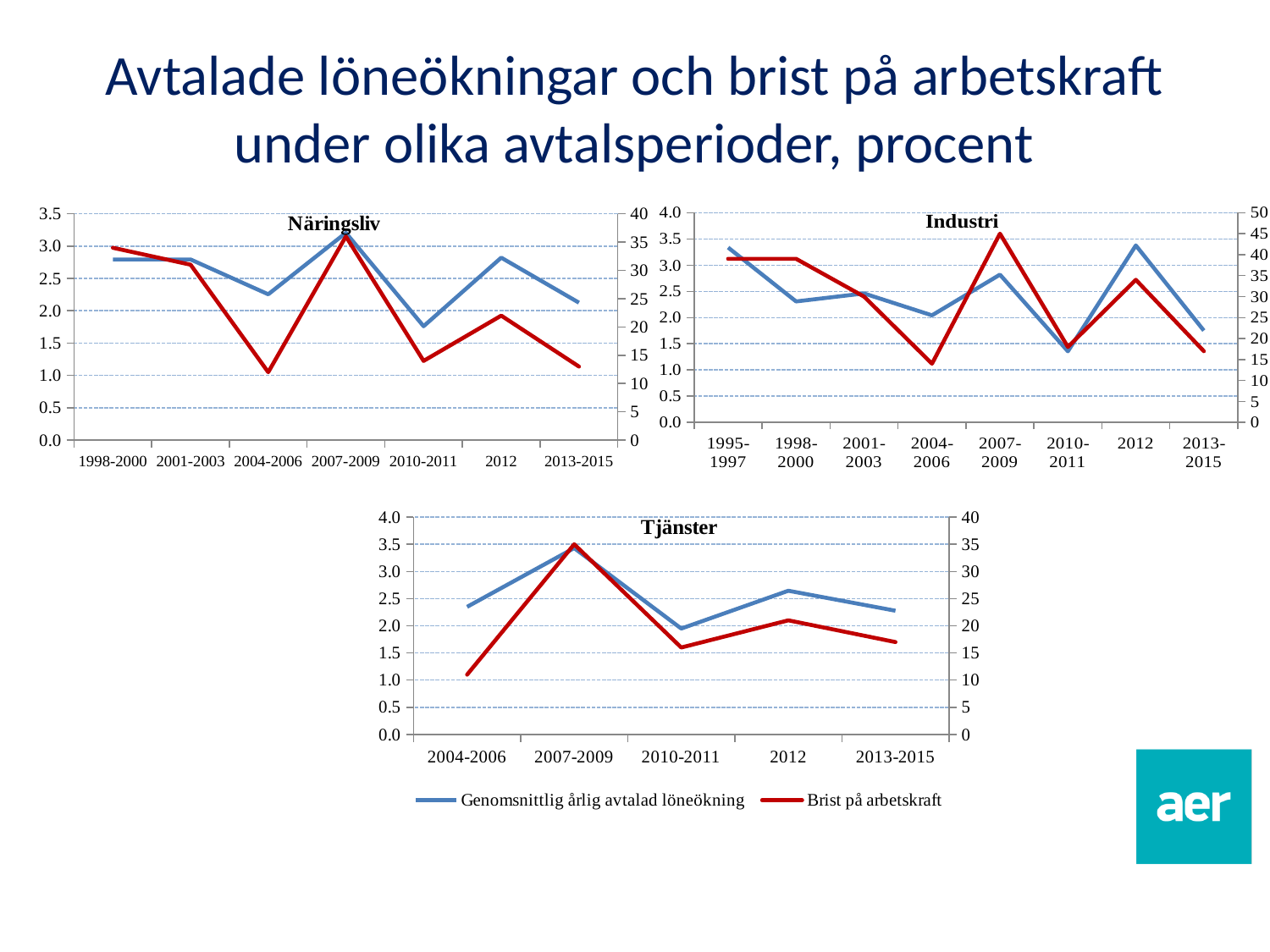
In the Näringsliv chart, in which period is Brist på arbetskraft lowest? 2004-2006 In the Tjänster chart, in which period is Genomsnittlig årlig avtalad löneökning lowest? 2010-2011 What type of chart is the Näringsliv chart? line chart How many series does the legend at the bottom of the slide list? 2 In the Näringsliv chart, how many periods are shown on the x axis? 7 In the Tjänster chart, how many periods are shown on the x axis? 5 In the Industri chart, how many periods are shown on the x axis? 8 In the Industri chart, is the value for Brist på arbetskraft in 2007-2009 greater or less than 40? greater In the Tjänster chart, does Brist på arbetskraft rise or fall from 2012 to 2013-2015? fall In the Industri chart, in which period is Brist på arbetskraft highest? 2007-2009 In the Näringsliv chart, in which period is Genomsnittlig årlig avtalad löneökning highest? 2007-2009 In the Tjänster chart, is the value for Brist på arbetskraft in 2004-2006 greater or less than 15? less